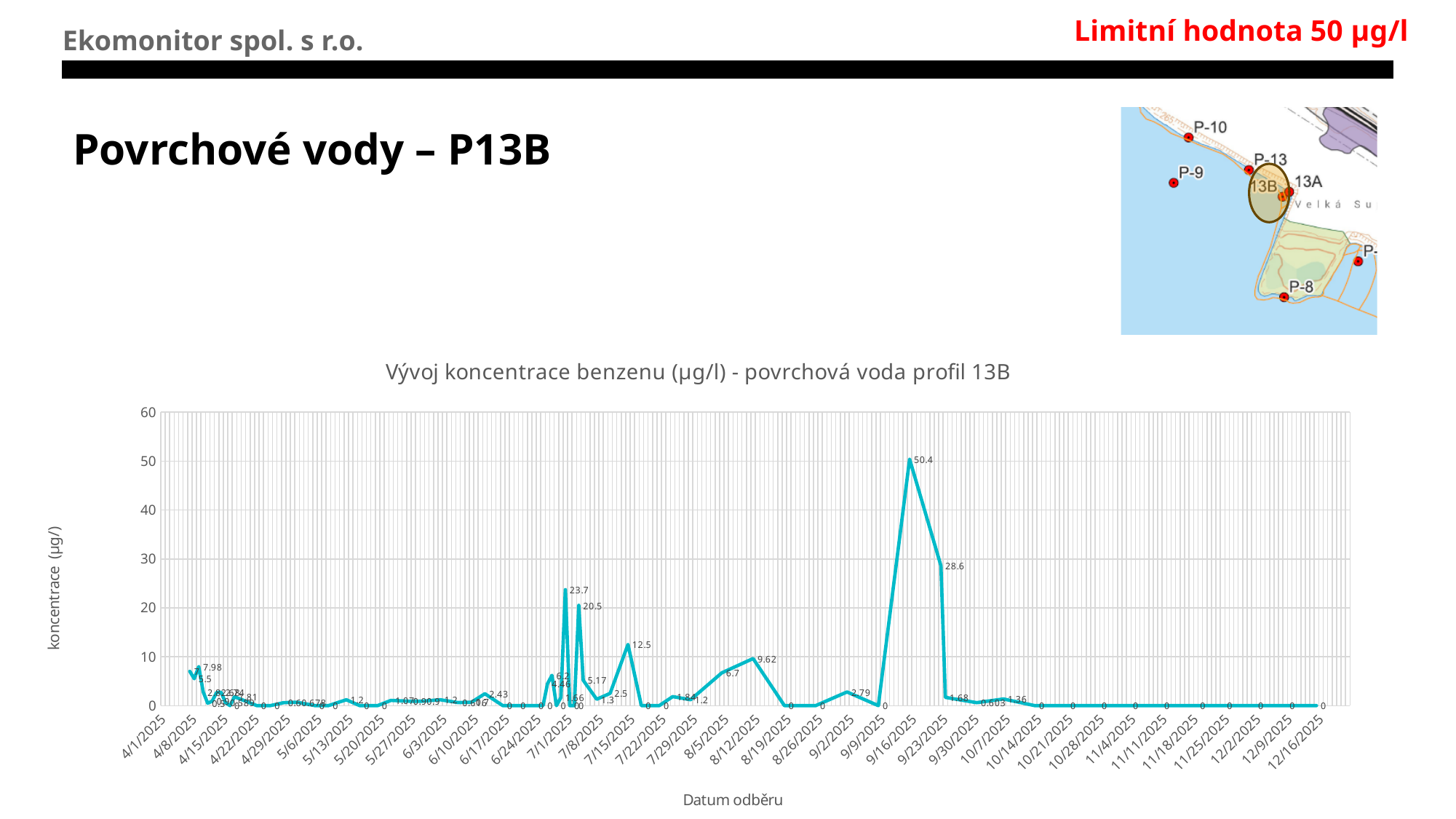
Does the concentration rise or fall between 9/16/2025 and 9/23/2025? fall What kind of chart is shown on the slide? line chart Is the peak value reached around 9/16/2025 greater or less than 50? greater Which is larger: the peak around 9/16/2025 or the peak around 7/1/2025? the peak around 9/16/2025 What is the highest benzene concentration value labelled on the chart? 50.4 What is the difference between the peak value 50.4 and the following labelled value 28.6? 21.8 What is the value labelled at the peak around 8/12/2025? 9.62 Are the values plotted after 10/14/2025 greater or less than 10? less What is the highest tick value shown on the vertical axis? 60 What is the title of the chart? Vývoj koncentrace benzenu (µg/l) - povrchová voda profil 13B What is the label of the vertical axis? koncentrace (µg/l) What is the value labelled at the peak around 7/15/2025? 12.5